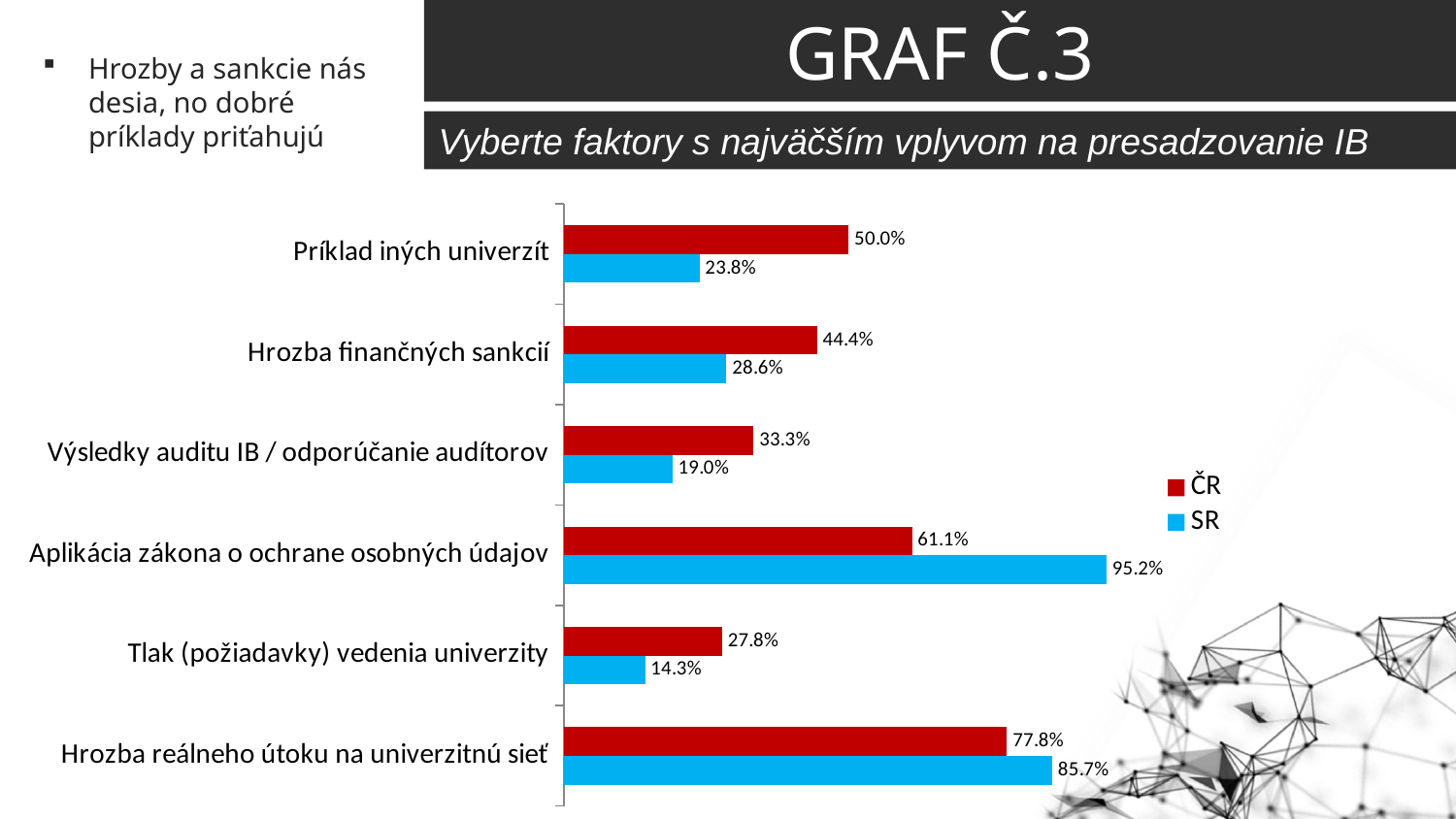
What kind of chart is shown on the slide? Bar chart Which category has the lowest SR value? Tlak (požiadavky) vedenia univerzity Which category has the highest ČR value? Hrozba reálneho útoku na univerzitnú sieť What is the difference between the SR and ČR values for "Aplikácia zákona o ochrane osobných údajov"? 34.1% Which is larger for "Hrozba finančných sankcií": the ČR value or the SR value? ČR What is the SR value for "Aplikácia zákona o ochrane osobných údajov"? 95.2% How many categories are shown in the chart? 6 Which colour represents the SR series in the chart? Blue What is the ČR value for "Výsledky auditu IB / odporúčanie audítorov"? 33.3% How many series does the legend list? 2 What is the SR value for "Tlak (požiadavky) vedenia univerzity"? 14.3% What is the ČR value for "Príklad iných univerzít"? 50.0%